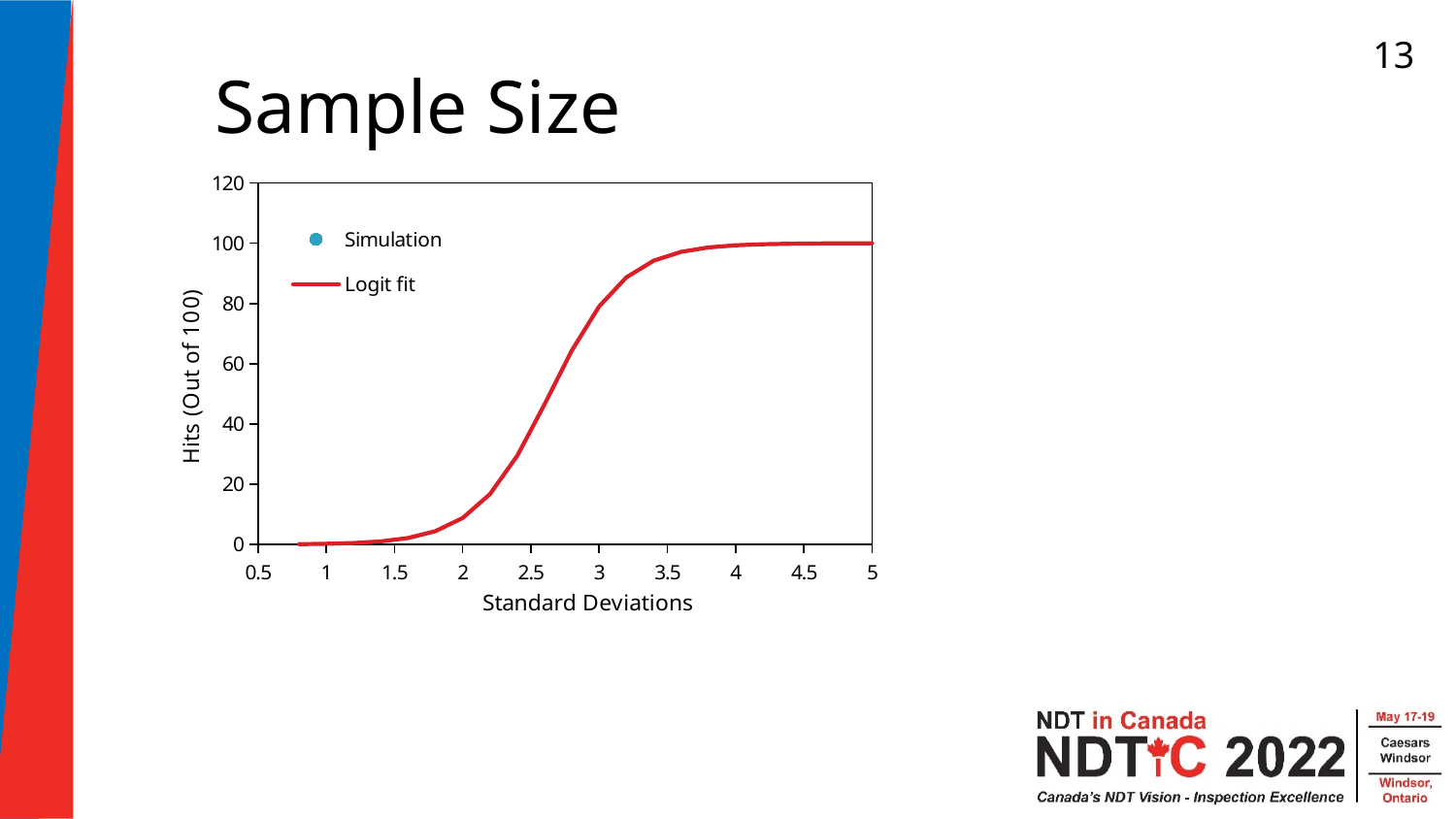
What are the two entries listed in the legend? Simulation and Logit fit Is the Logit fit value at 3 standard deviations greater or less than 60? greater How many series does the legend list? 2 Is the Logit fit value at 4 standard deviations greater or less than 80? greater What is the title of the y axis? Hits (Out of 100) Is the Logit fit value at 1.5 standard deviations greater or less than 20? less What kind of chart is shown on the slide? line chart Do the values of the Logit fit rise or fall as Standard Deviations increase along the x axis? rise